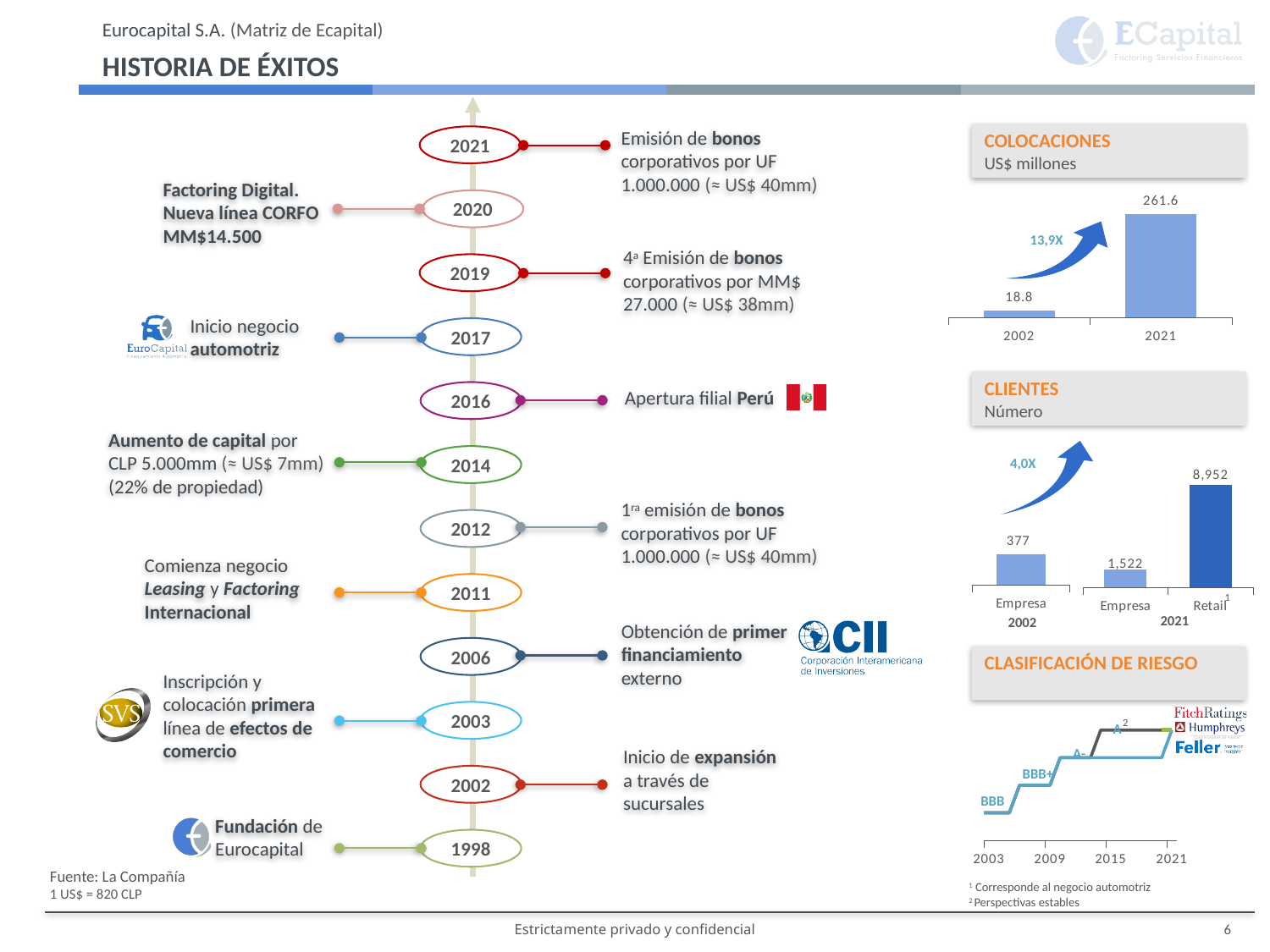
In the CLASIFICACIÓN DE RIESGO chart, what is the first rating shown in 2003? BBB In the CLIENTES chart, what is the value for Empresa in 2002? 377 What type of chart is the COLOCACIONES chart? Bar chart In the COLOCACIONES chart, what is the value for 2021? 261.6 In the COLOCACIONES chart, what is the difference between the 2021 and 2002 values? 242.8 In the CLIENTES chart, what is the value for Retail in 2021? 8,952 In the CLIENTES chart, which bar has the highest value? Retail 2021 In the COLOCACIONES chart, how many bars are plotted? 2 In the CLIENTES chart, which bar has the lowest value? Empresa 2002 In the CLIENTES chart, what is the value for Empresa in 2021? 1,522 In the COLOCACIONES chart, what is the value for 2002? 18.8 In the CLIENTES chart, what is the difference between Empresa 2021 and Empresa 2002? 1,145